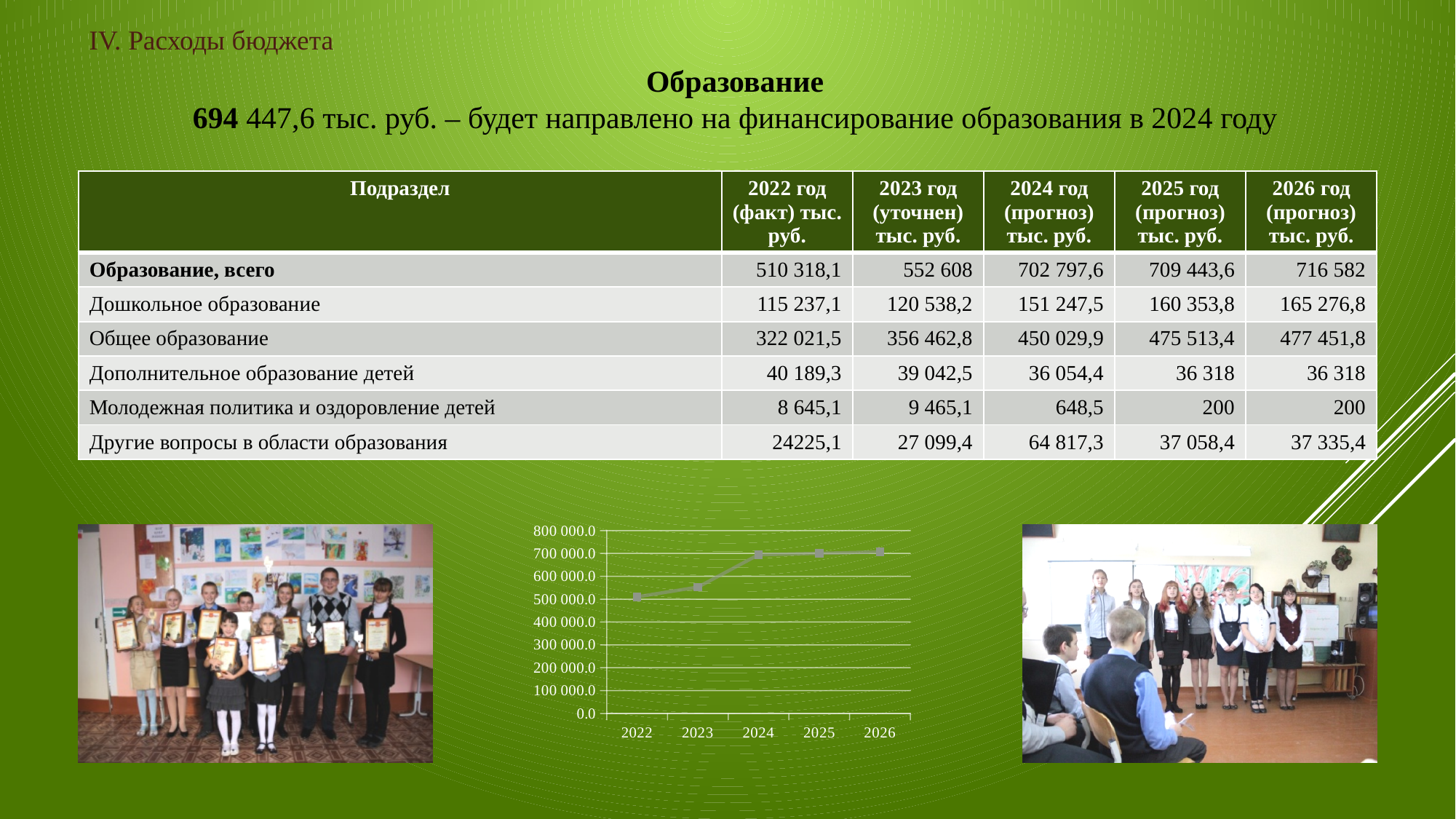
On the line chart, is the value for 2023 greater or less than 600 000.0? less On the line chart, is the value for 2026 greater or less than 600 000.0? greater What kind of chart is shown at the bottom centre of the slide? line chart Do the values on the line chart rise or fall from 2022 to 2026? rise Which year has the lowest value on the line chart? 2022 On the line chart, which is larger: the value for 2023 or the value for 2022? 2023 What is the highest tick value shown on the y axis of the line chart? 800 000.0 On the line chart, which is larger: the value for 2022 or the value for 2024? 2024 On the line chart, is the value for 2024 greater or less than 600 000.0? greater How many years are plotted along the x axis of the line chart? 5